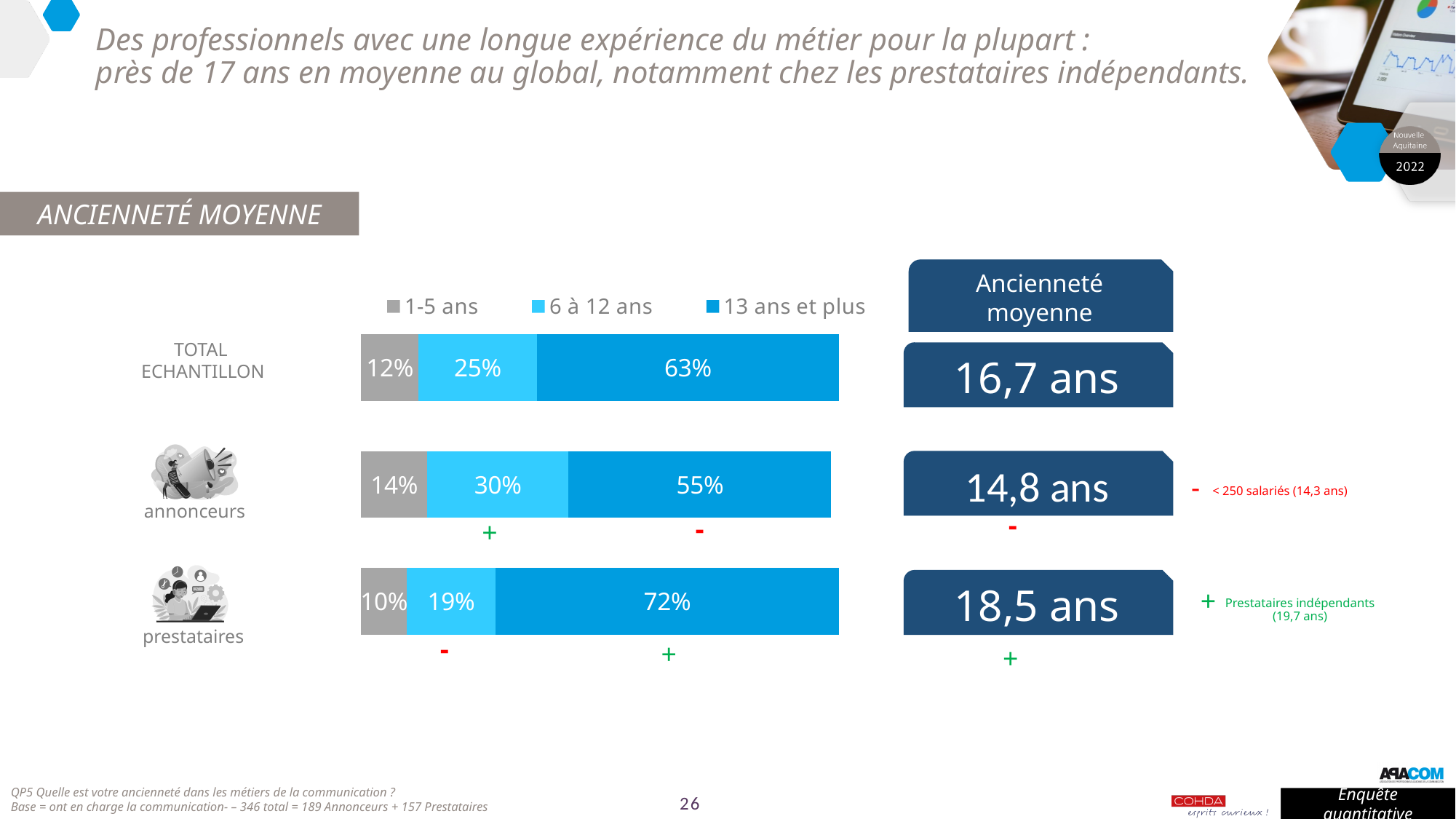
Which is larger: the '6 à 12 ans' value for annonceurs or for prestataires? annonceurs What is the value for '13 ans et plus' for TOTAL ECHANTILLON? 63% What is the value for '6 à 12 ans' for annonceurs? 30% What kind of chart is shown on the slide? Stacked bar chart What is the total of the stacked bar for annonceurs? 99% Which category has the highest value for '13 ans et plus'? prestataires What is the difference between the '13 ans et plus' values for prestataires and annonceurs? 17 percentage points What is the value for '1-5 ans' for prestataires? 10% Which legend entry is shown in grey? 1-5 ans Which category has the lowest value for '1-5 ans'? prestataires How many categories (rows) are plotted in the chart? 3 How many series does the chart legend list? 3